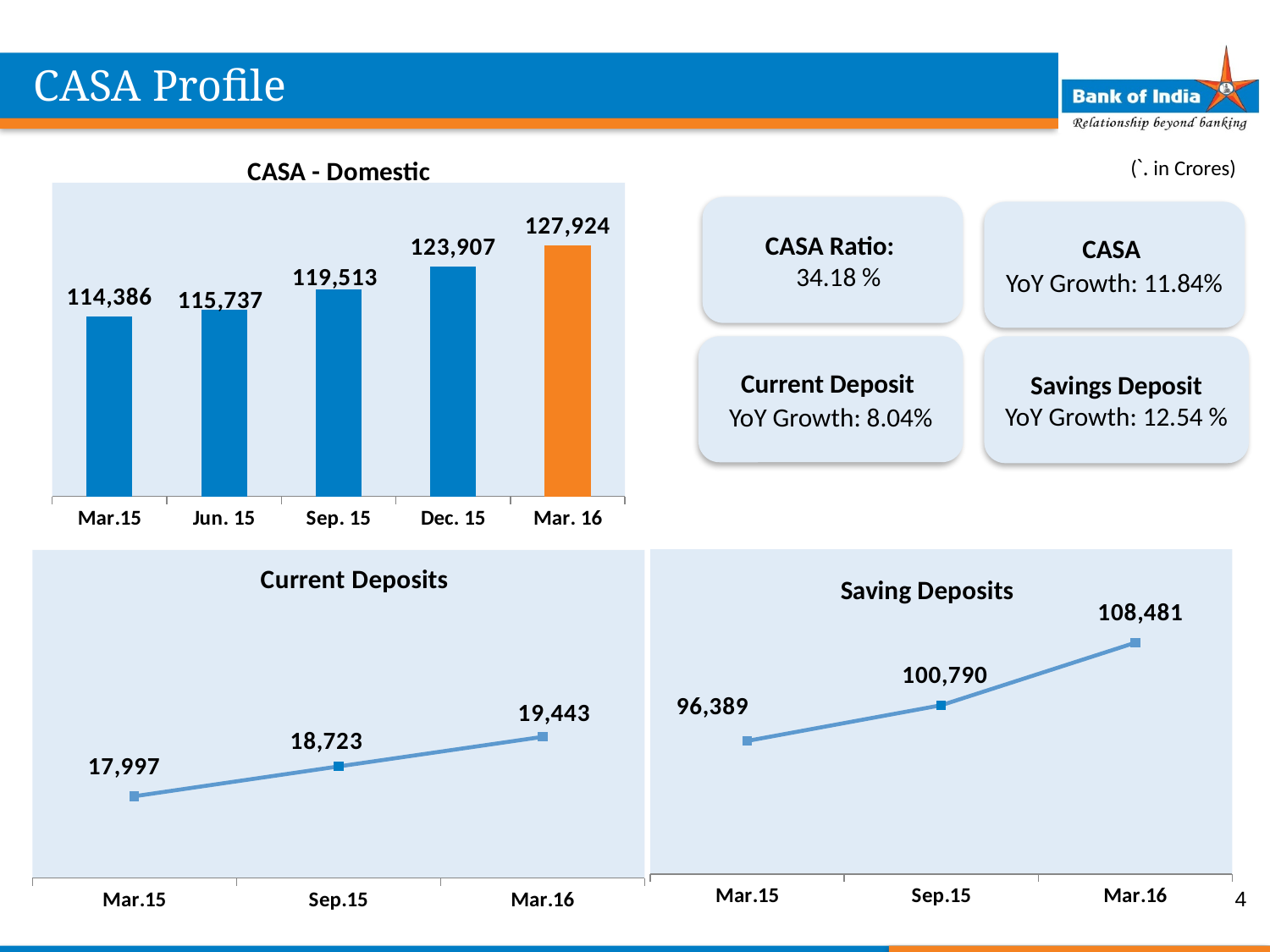
In the CASA - Domestic chart, how many bars are plotted? 5 In the Current Deposits chart, what is the value for Sep.15? 18,723 In the Saving Deposits chart, what is the difference between the Mar.16 and Mar.15 values? 12,092 In the Current Deposits chart, do the values rise or fall from Mar.15 to Mar.16? Rise What kind of chart is the CASA - Domestic chart? Bar chart In the CASA - Domestic chart, which period has the lowest value? Mar.15 In the CASA - Domestic chart, what is the value for Sep. 15? 119,513 In the CASA - Domestic chart, which bar is coloured orange? Mar. 16 What kind of chart is the Saving Deposits chart? Line chart In the CASA - Domestic chart, what is the difference between the Mar. 16 and Mar.15 values? 13,538 In the Saving Deposits chart, what is the value for Mar.16? 108,481 In the CASA - Domestic chart, what is the value for Mar. 16? 127,924